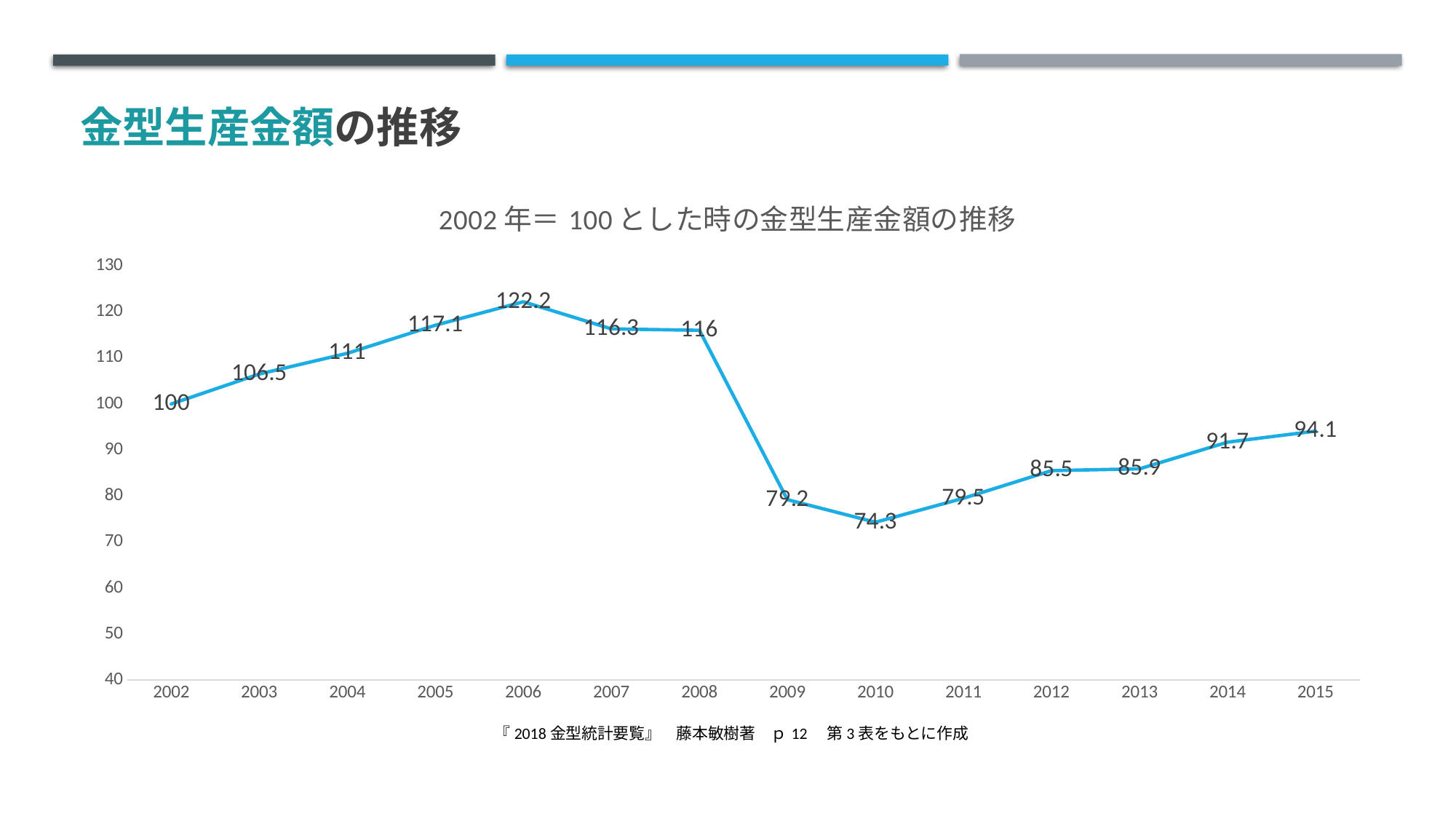
What is the difference between the values for 2008 and 2009? 36.8 What is the title of the chart? 2002年＝100とした時の金型生産金額の推移 How many years are plotted on the x axis? 14 Which year has the lowest value? 2010 Which year has the highest value? 2006 Which is larger, the value for 2004 or the value for 2014? 2004 What is the value for 2010? 74.3 What kind of chart is shown? line chart What is the value for 2015? 94.1 What is the difference between the values for 2006 and 2010? 47.9 What is the value for 2006? 122.2 Do the values rise or fall from 2010 to 2015? rise